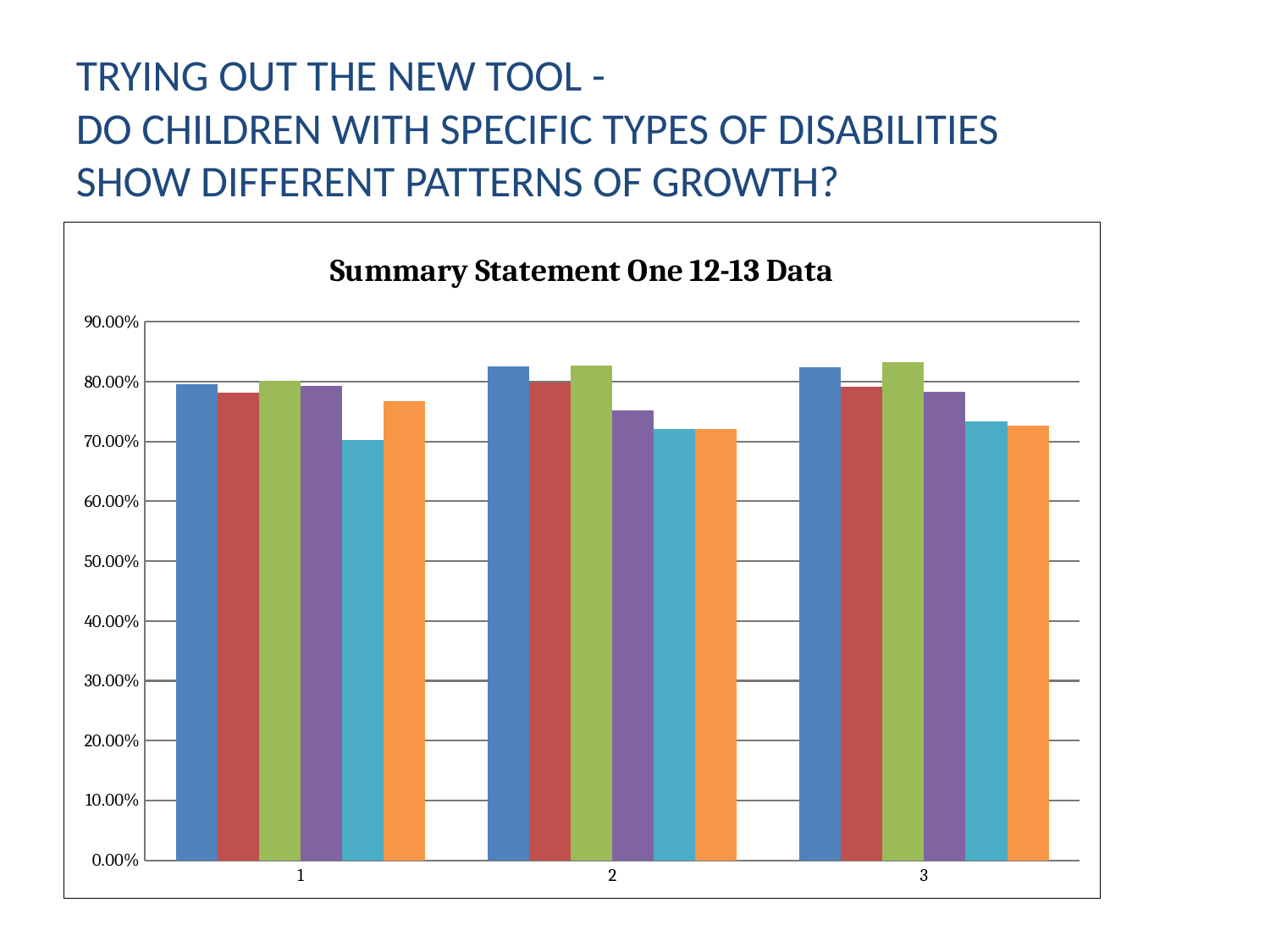
How many bars are plotted in each category group of the chart? 6 In category 1, which bar is the lowest? the light blue bar In category 1, which is larger: the light blue bar or the orange bar? the orange bar Is the value of the green bar in category 3 greater or less than 80.00%? greater Is the value of the orange bar in category 2 greater or less than 80.00%? less Is the value of the dark blue bar in category 2 greater or less than 80.00%? greater What is the title of the chart? Summary Statement One 12-13 Data What is the highest value shown on the y axis of the chart? 90.00% In category 2, which is larger: the dark blue bar or the light blue bar? the dark blue bar What kind of chart is shown on the slide? bar chart How many categories are shown on the x axis of the chart? 3